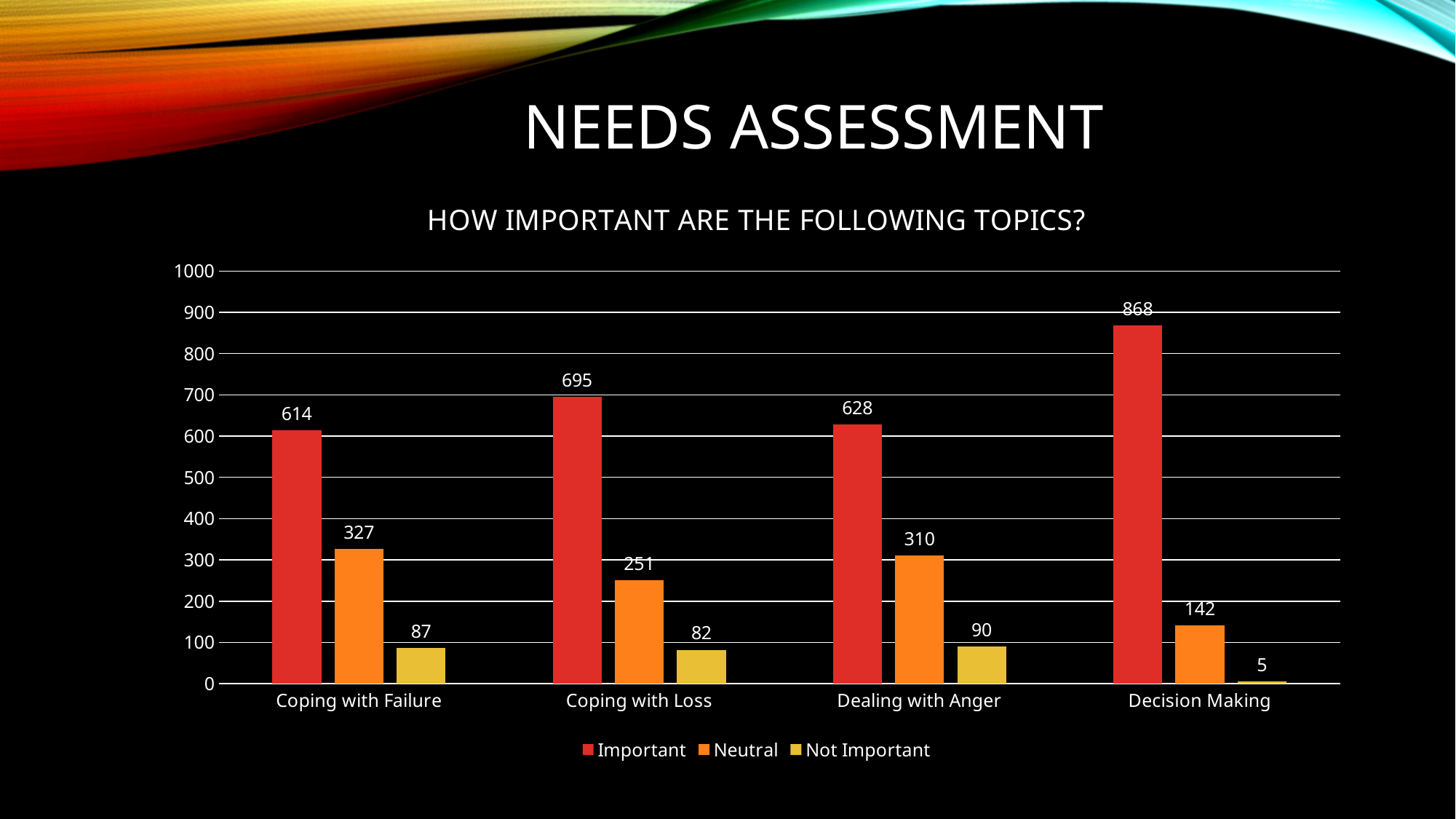
Which is larger, the Neutral value for Coping with Failure or the Neutral value for Dealing with Anger? Coping with Failure Is the Important value for Coping with Loss greater or less than 700? less How many series does the legend list? 3 What is the title of the chart? How important are the following topics? How many topics are shown on the x axis? 4 What is the Important value for Decision Making? 868 What is the difference between the Important values for Decision Making and Coping with Failure? 254 What kind of chart is shown? bar chart Which topic has the lowest Not Important value? Decision Making What is the Not Important value for Dealing with Anger? 90 Which topic has the highest Important value? Decision Making What is the Neutral value for Coping with Loss? 251